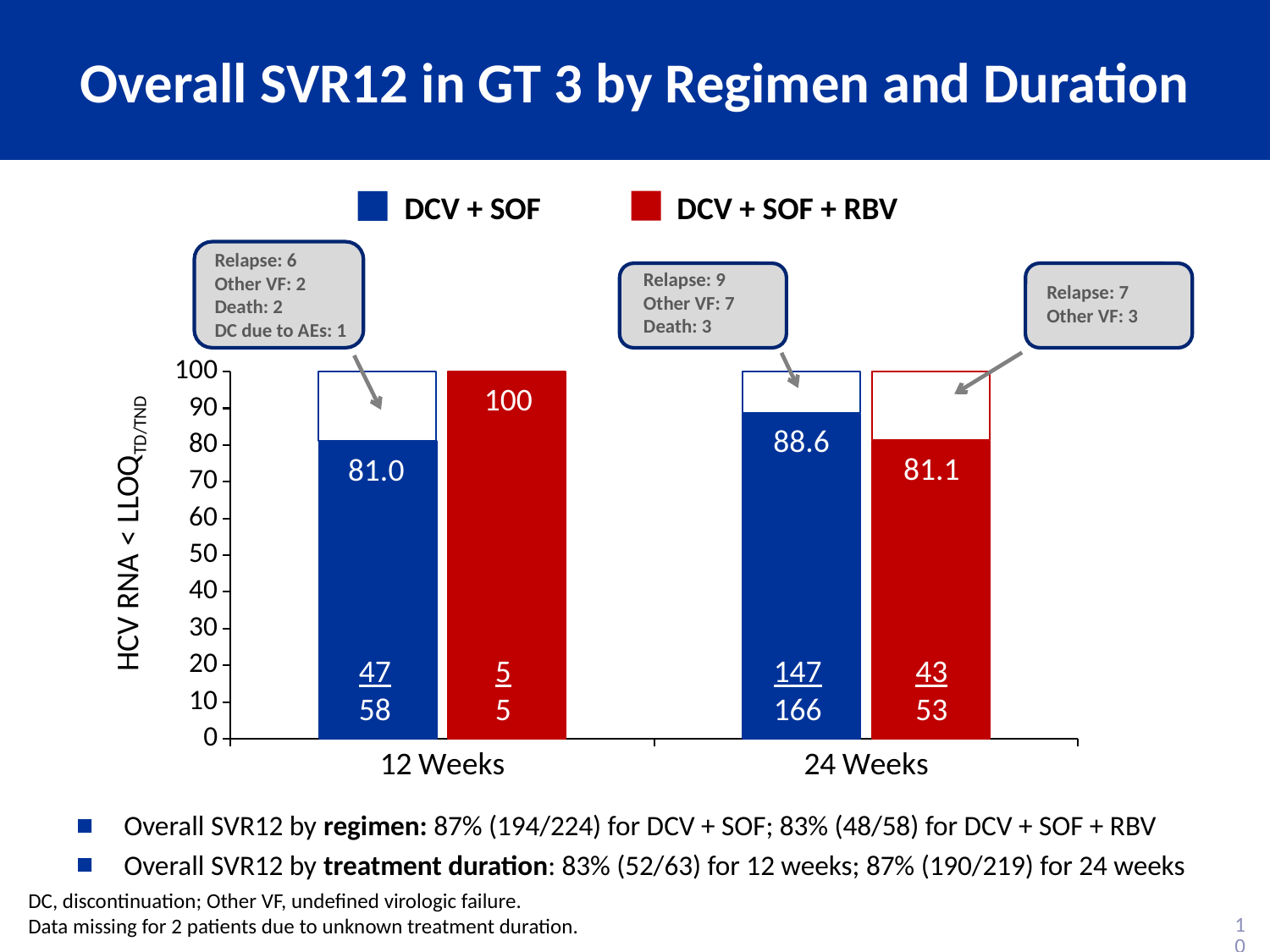
What is the SVR12 value for DCV + SOF at 12 Weeks? 81.0 Which regimen and duration has the highest SVR12 value? DCV + SOF + RBV at 12 Weeks What is the SVR12 value for DCV + SOF at 24 Weeks? 88.6 How many duration categories are shown on the x axis? 2 Which regimen and duration has the lowest SVR12 value? DCV + SOF at 12 Weeks How many series does the legend list? 2 What colour represents DCV + SOF + RBV in the chart? Red What is the SVR12 value for DCV + SOF + RBV at 24 Weeks? 81.1 What is the difference between the SVR12 values for DCV + SOF at 24 Weeks and at 12 Weeks? 7.6 Which is larger at 24 Weeks: the SVR12 value for DCV + SOF or for DCV + SOF + RBV? DCV + SOF What is the SVR12 value for DCV + SOF + RBV at 12 Weeks? 100 What kind of chart is shown on the slide? Bar chart